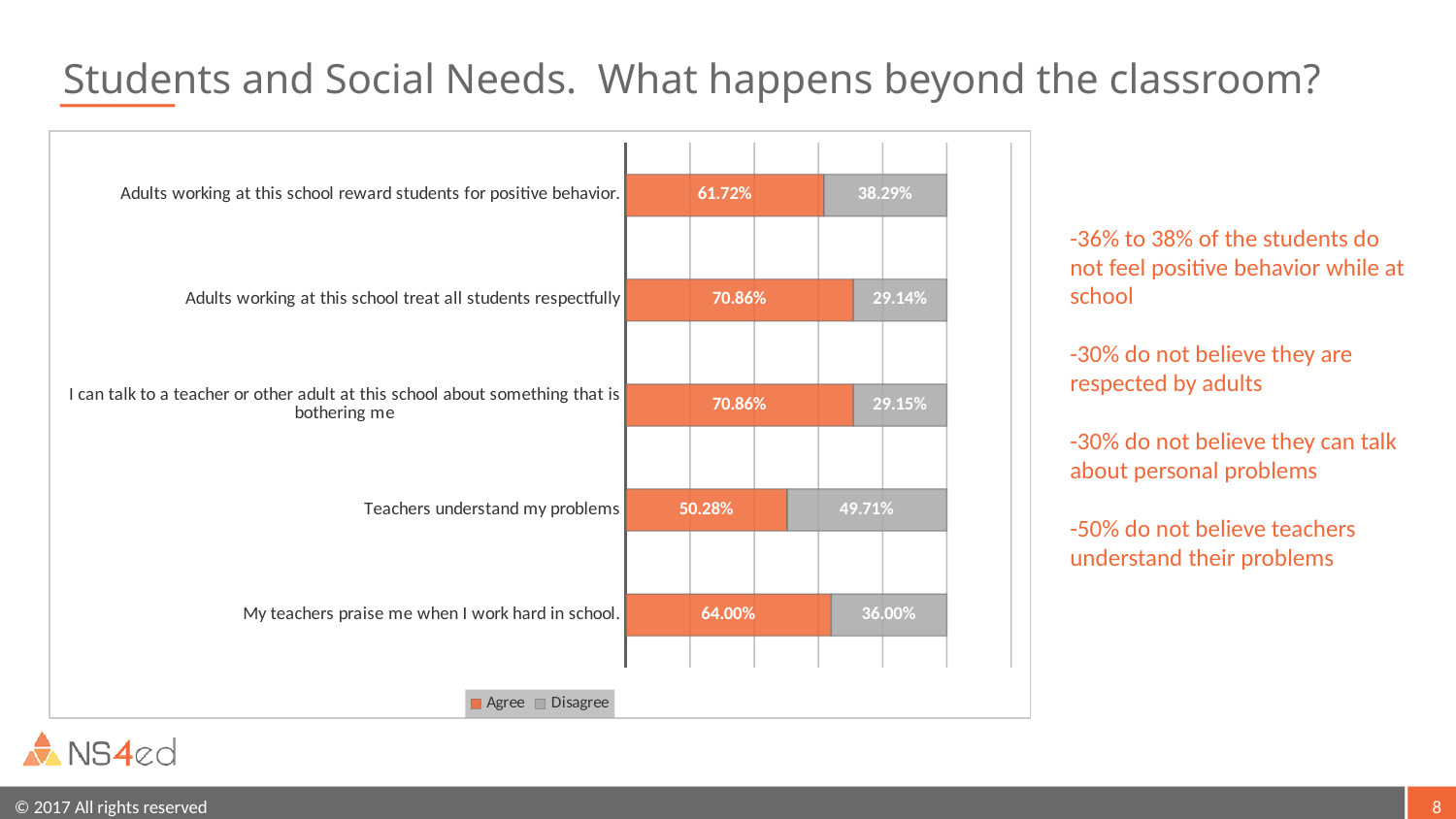
For "My teachers praise me when I work hard in school.", what is the difference between the Agree and Disagree values? 28.00% Which statement has the lowest Agree percentage? Teachers understand my problems What is the Disagree value for "I can talk to a teacher or other adult at this school about something that is bothering me"? 29.15% What kind of chart is shown on the slide? Stacked bar chart What is the Agree value for "My teachers praise me when I work hard in school."? 64.00% What is the Disagree value for "Adults working at this school reward students for positive behavior."? 38.29% How many statements (categories) are shown in the chart? 5 What are the two entries in the chart legend? Agree and Disagree Which statement has the highest Disagree percentage? Teachers understand my problems Which has a larger Agree value: "Adults working at this school treat all students respectfully" or "Adults working at this school reward students for positive behavior."? Adults working at this school treat all students respectfully What percentage of students agree that "Teachers understand my problems"? 50.28% How many series does the legend list? 2